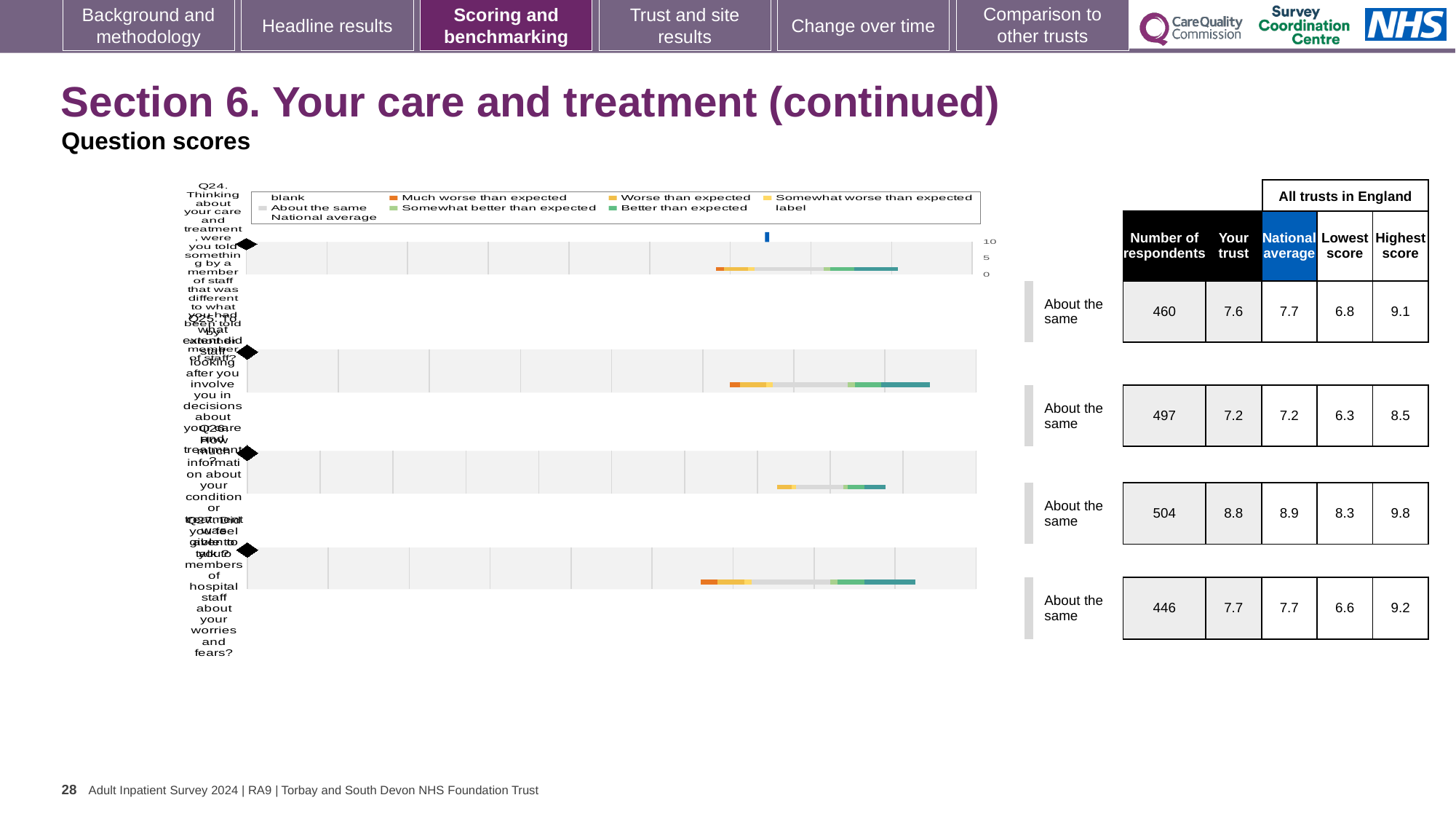
Which row has the highest 'Your trust' score in the table beside the chart? Q26 (third row) What benchmark category is shown for every question row in the chart? About the same Which row has the lowest number of respondents in the table beside the chart? Q27 (fourth row) In the table beside the chart, what is the highest score for the fourth row (Q27)? 9.2 In the table beside the chart, what is the number of respondents for the first row (Q24)? 460 For the first row (Q24), which is larger: the 'Your trust' score or the national average? National average What is the highest tick value shown on the chart's score axis? 10 What kind of chart is used to show the question scores on this slide? bar chart What is the difference between the highest score and the lowest score for the first row (Q24)? 2.3 How many question rows are plotted in the chart? 4 In the table beside the chart, what is the national average for the second row (Q25)? 7.2 In the table beside the chart, what is the 'Your trust' score for the third row (Q26)? 8.8